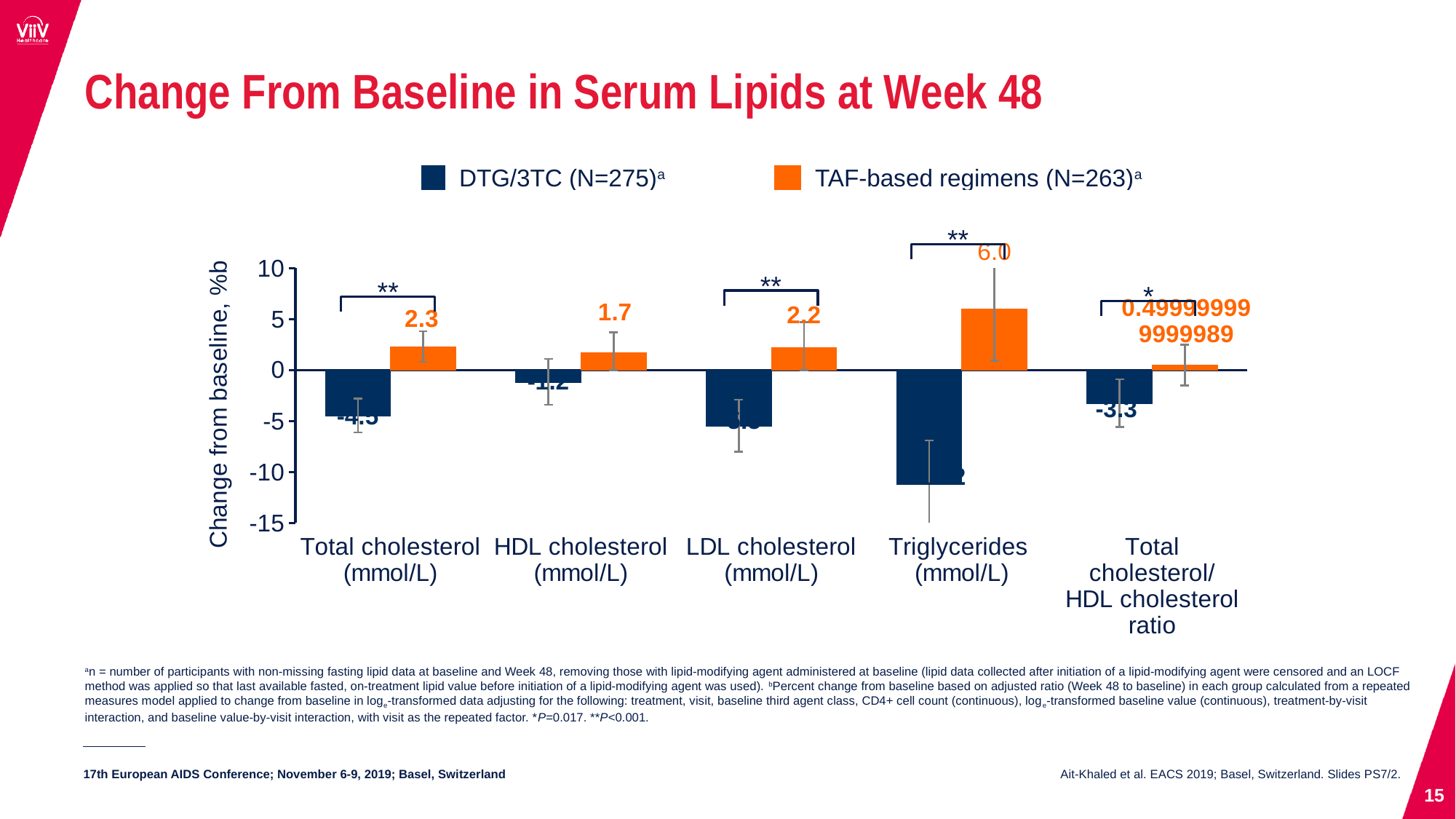
What is the change from baseline for TAF-based regimens in Triglycerides (mmol/L)? 6.0 For TAF-based regimens, which category has the highest change from baseline? Triglycerides (mmol/L) What is the change from baseline for TAF-based regimens in Total cholesterol (mmol/L)? 2.3 What kind of chart is shown on the slide? Bar chart What is the change from baseline for TAF-based regimens in LDL cholesterol (mmol/L)? 2.2 What is the change from baseline for TAF-based regimens in HDL cholesterol (mmol/L)? 1.7 How many lipid categories are shown on the x axis? 5 How many series does the legend list? 2 Is the DTG/3TC value for Triglycerides (mmol/L) greater or less than -5? less For DTG/3TC, which category has the lowest (most negative) change from baseline? Triglycerides (mmol/L) What is the difference between the TAF-based regimens values for Triglycerides and Total cholesterol? 3.7 What is the change from baseline for DTG/3TC in the Total cholesterol/HDL cholesterol ratio? -3.3